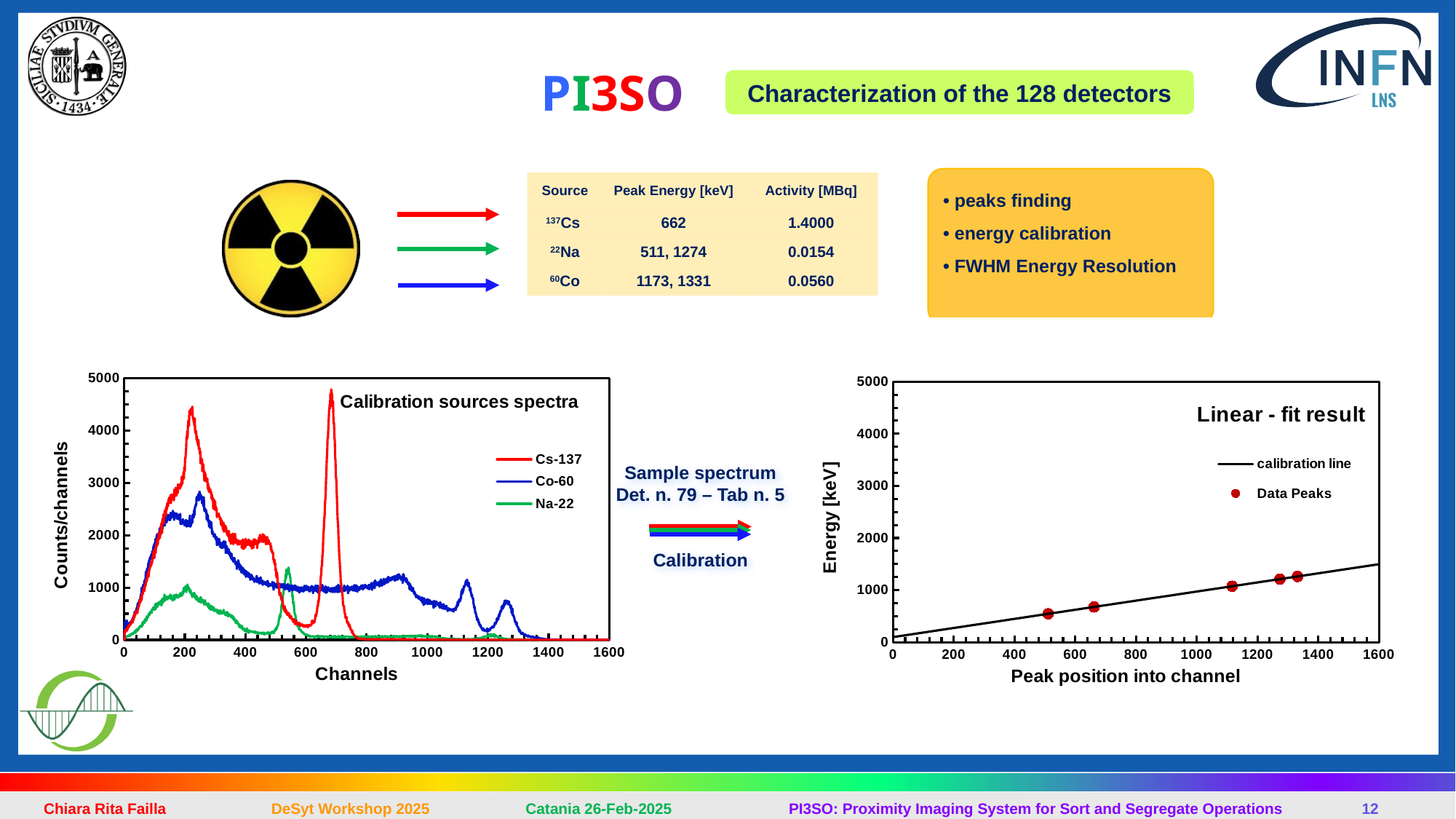
How many entries does the legend of the 'Linear - fit result' chart list? 2 In the 'Calibration sources spectra' chart, which series reaches a higher peak, Co-60 or Na-22? Co-60 How many series does the legend of the 'Calibration sources spectra' chart list? 3 In the 'Linear - fit result' chart, is the energy of the data peak at the highest channel position greater or less than 1000 keV? greater What kind of chart is the 'Calibration sources spectra' chart? line chart In the 'Calibration sources spectra' chart, is the highest peak of Cs-137 greater or less than 4000 counts/channels? greater In the 'Calibration sources spectra' chart, which series reaches the highest count? Cs-137 In the 'Calibration sources spectra' chart, is the highest peak of Na-22 greater or less than 2000 counts/channels? less How many data peaks are plotted in the 'Linear - fit result' chart? 5 What is the x-axis label of the 'Calibration sources spectra' chart? Channels In the 'Calibration sources spectra' chart, which series has the lowest peak? Na-22 In the 'Linear - fit result' chart, does the energy rise or fall as the peak position into channel increases? rises